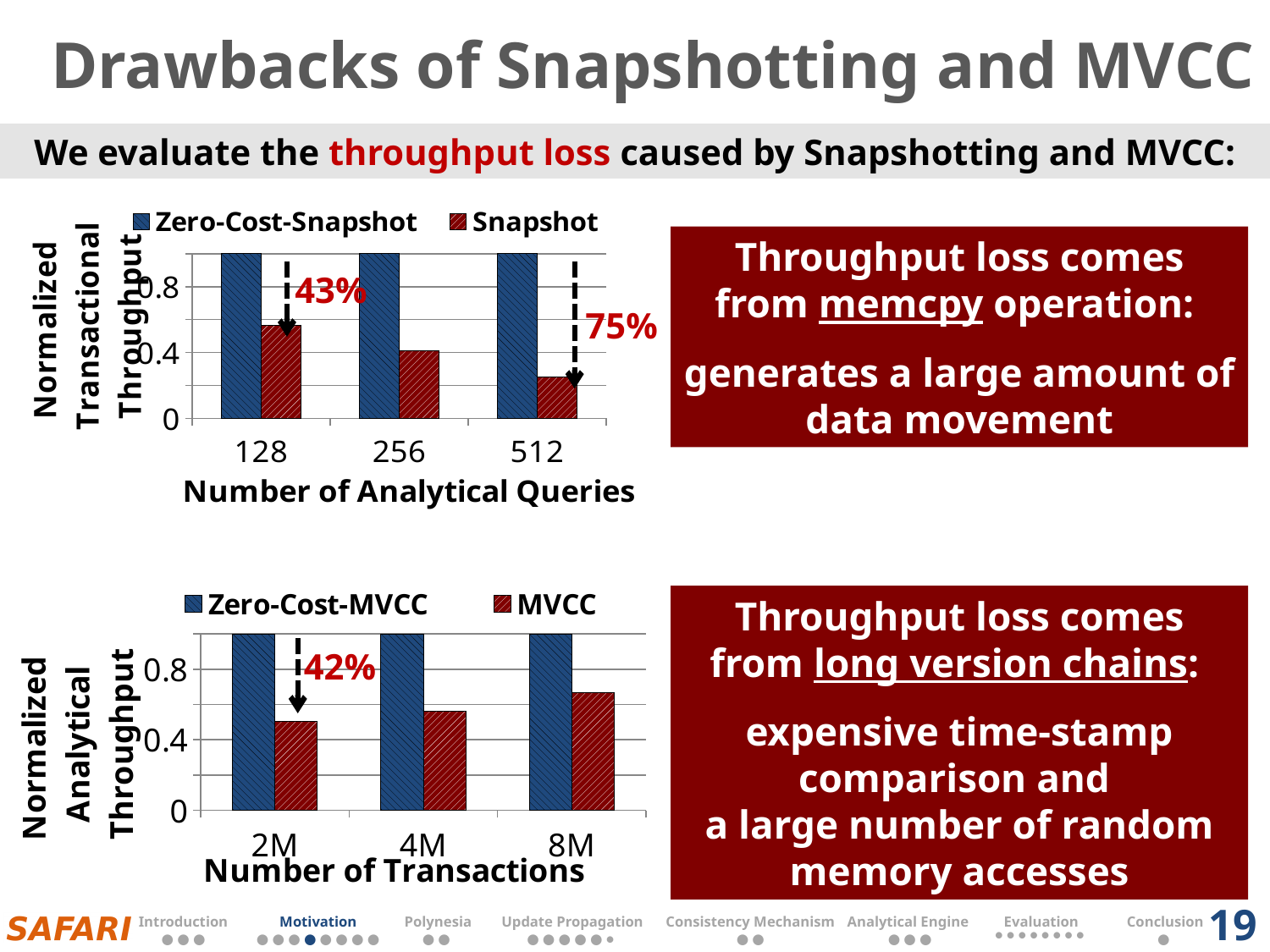
In the top chart, at which number of analytical queries is the Snapshot throughput lowest? 512 In the bottom chart, does the MVCC throughput rise or fall as the number of transactions increases from 2M to 8M? rise In the bottom chart (Zero-Cost-MVCC vs MVCC), what are the two series listed in the legend? Zero-Cost-MVCC and MVCC In the bottom chart, at which number of transactions is the MVCC throughput highest? 8M In the top chart, does the Snapshot throughput rise or fall as the number of analytical queries increases? fall In the top chart, is the Snapshot value at 512 analytical queries greater or less than 0.4? less In the bottom chart, is the MVCC value at 8M transactions greater or less than 0.8? less In the top chart, what throughput loss percentage is annotated at 512 analytical queries? 75% In the top chart, is the Snapshot value at 128 analytical queries greater or less than 0.4? greater In the top chart, how many series does the legend list? 2 What kind of chart is the top chart on the slide (Zero-Cost-Snapshot vs Snapshot)? bar chart In the top chart, how many categories are shown on the x axis (Number of Analytical Queries)? 3